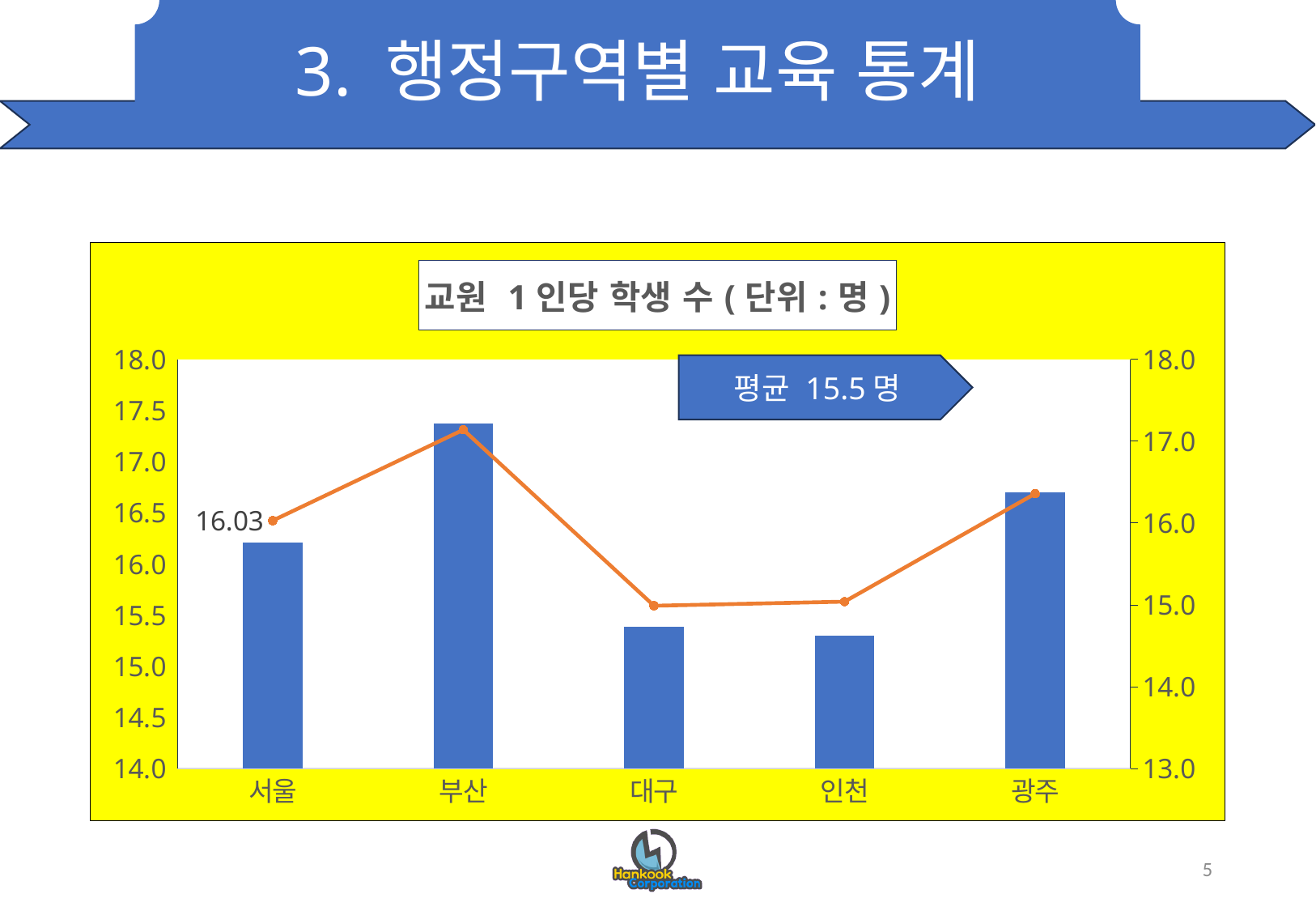
What kind of chart is shown on the slide? A bar chart combined with a line chart Is the bar for 인천 greater or less than 15.5 on the left axis? less Which region has the tallest bar in the chart? 부산 Which bar is taller, 광주 or 대구? 광주 Is the bar for 대구 greater or less than 16.0 on the left axis? less How many regions (categories) are shown on the x axis of the chart? 5 What is the data label shown on the line at 서울? 16.03 Is the bar for 부산 greater or less than 17.0 on the left axis? greater Does the line rise or fall from 부산 to 대구? fall Which bar is taller, 부산 or 서울? 부산 What average value (평균) is shown in the callout on the chart? 15.5 명